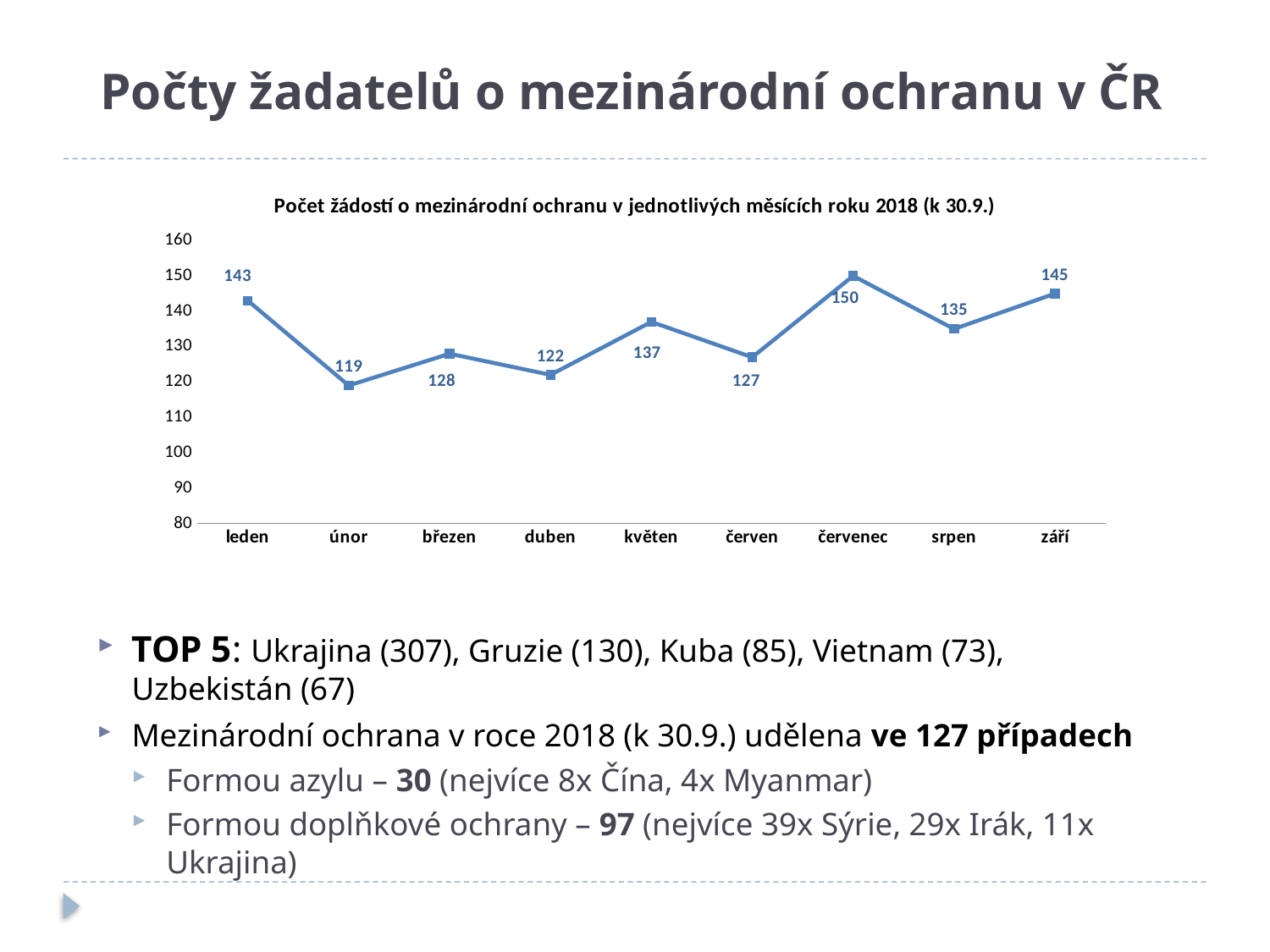
Which month has the highest value? červenec What is the value for leden? 143 What is the title of the chart? Počet žádostí o mezinárodní ochranu v jednotlivých měsících roku 2018 (k 30.9.) How many months are plotted on the chart? 9 What is the difference between the values for červenec and únor? 31 What is the value for červen? 127 Do the values rise or fall from leden to únor? fall What is the value for září? 145 Is the value for duben greater or less than 130? less Which month has the lowest value? únor Which is larger, the value for květen or the value for srpen? květen What kind of chart is shown on the slide? line chart